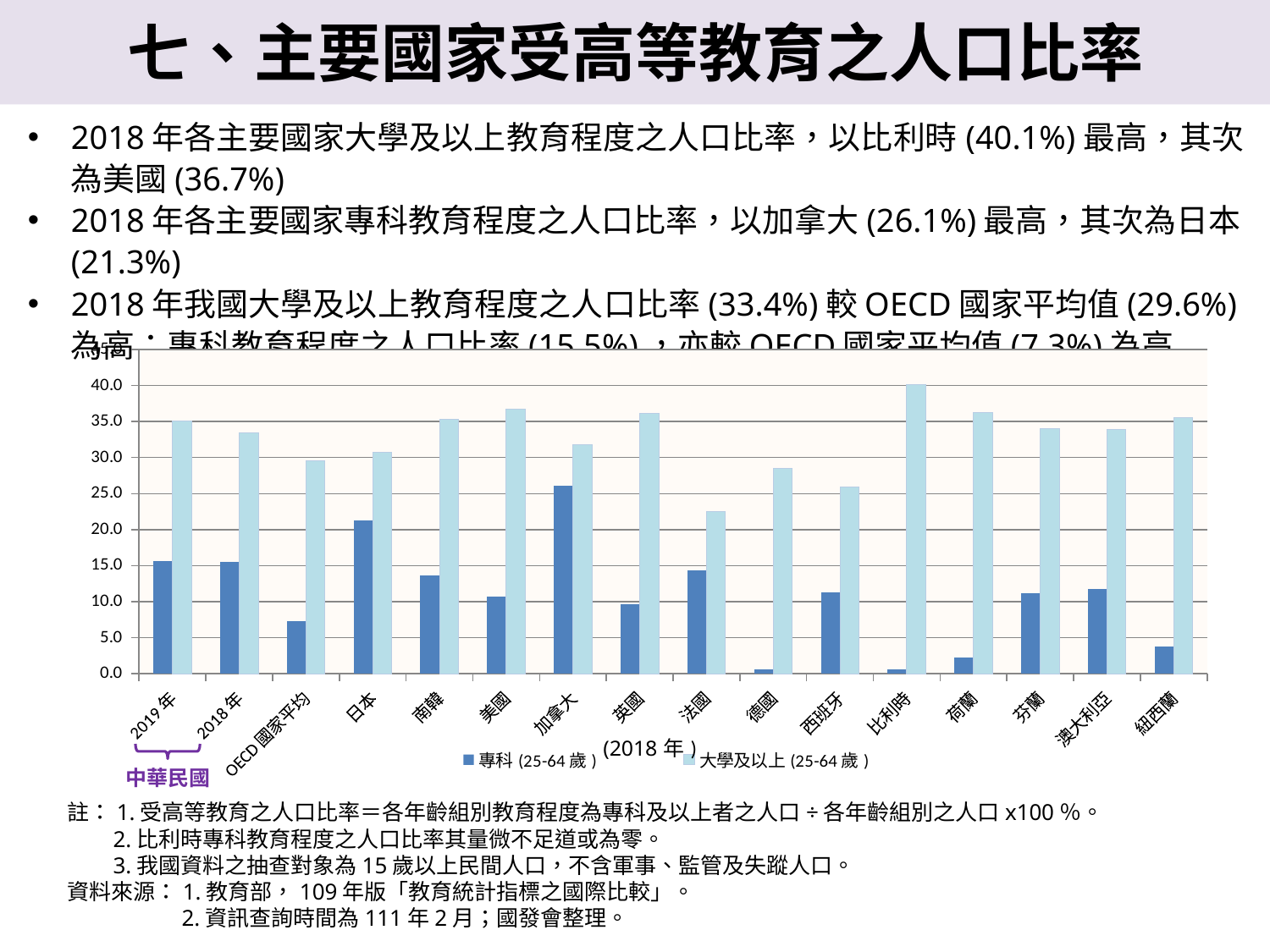
How many series does the chart legend list? 2 What is the difference between 比利時 (40.1%) and 美國 (36.7%) in the 大學及以上 series? 3.4% Is the value for 德國 in the 大學及以上 series greater or less than 30.0? less Which category has the highest value for 專科 (25-64歲)? 加拿大 What is the value for 加拿大 in the 專科 series? 26.1% What is the value for 比利時 in the 大學及以上 series? 40.1% Which category has the highest value for 大學及以上 (25-64歲)? 比利時 Which is larger in the 專科 series, 加拿大 or 日本? 加拿大 What kind of chart is shown on the slide? bar chart Which category has the lowest value for 大學及以上 (25-64歲)? 法國 Is the value for 日本 in the 專科 series greater or less than 20.0? greater How many categories are shown along the x axis of the chart? 16